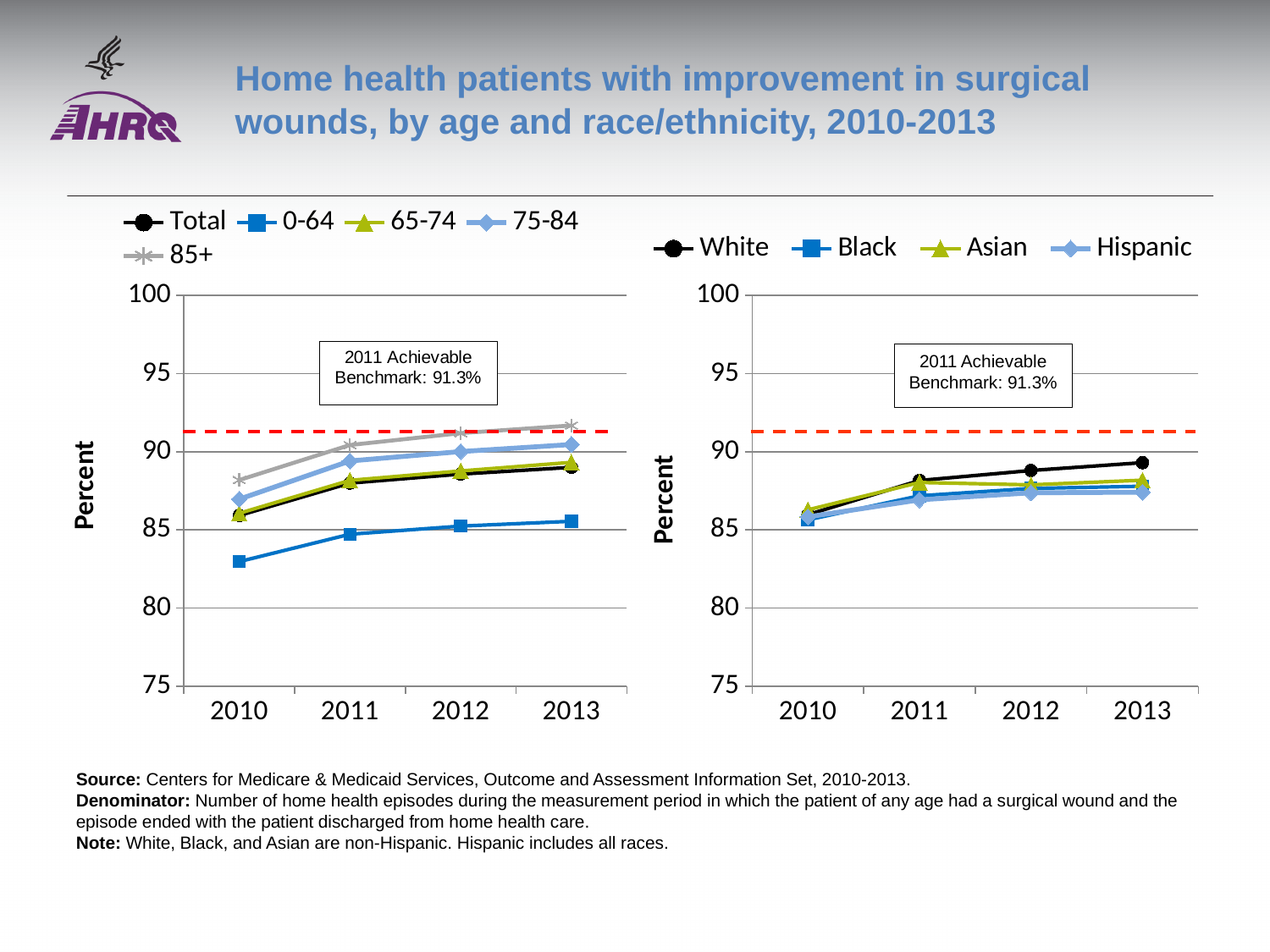
How many series does the legend of the left chart (by age) list? 5 In the right chart (by race/ethnicity), which group has the highest value in 2013? White What is the 2011 Achievable Benchmark shown on the charts? 91.3% In the left chart (by age), is the value for 85+ in 2013 greater or less than 90? greater In the right chart (by race/ethnicity), do the values for White rise or fall from 2010 to 2013? rise How many series does the legend of the right chart (by race/ethnicity) list? 4 In the left chart (by age), which age group has the highest value in 2013? 85+ How many years are shown on the x axis of the right chart (by race/ethnicity)? 4 What kind of chart is the left chart (by age)? line chart In the left chart (by age), which age group has the lowest values across all years? 0-64 In the right chart (by race/ethnicity), is the value for White in 2013 greater or less than 90? less In the left chart (by age), is the value for 0-64 in 2010 greater or less than 85? less